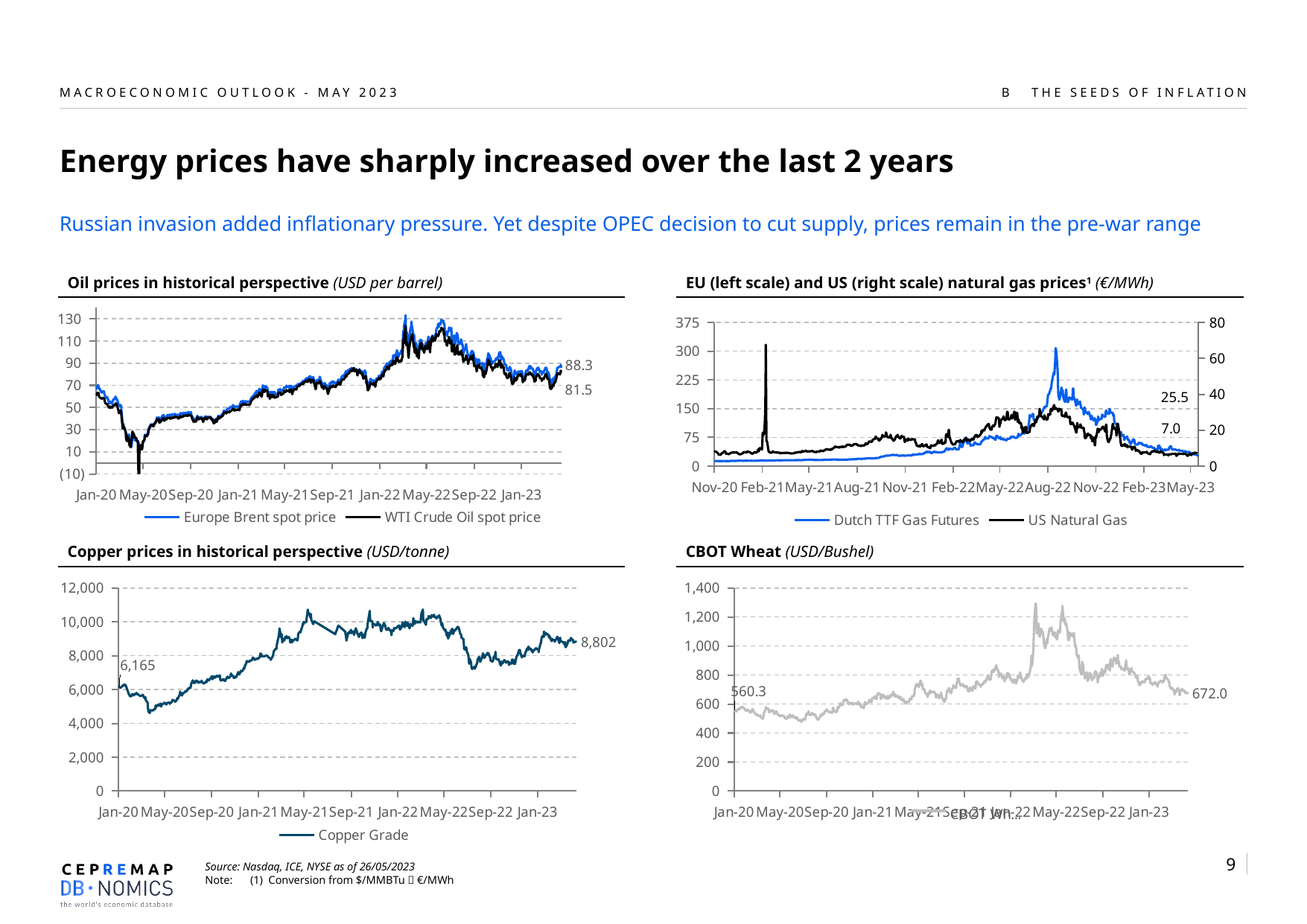
In the 'Copper prices in historical perspective' chart, is the peak value of Copper Grade greater or less than 10,000? greater In the 'Copper prices in historical perspective' chart, what is the last labelled value of Copper Grade? 8,802 In the 'Copper prices in historical perspective' chart, what is the first labelled value of Copper Grade? 6,165 In the 'Oil prices in historical perspective' chart, what is the difference between the latest labelled Brent value and the latest labelled WTI value? 6.8 In the 'Oil prices in historical perspective' chart, what is the latest labelled value for WTI Crude Oil spot price? 81.5 In the 'Oil prices in historical perspective' chart, which series has the higher latest labelled value, Europe Brent spot price or WTI Crude Oil spot price? Europe Brent spot price In the 'CBOT Wheat' chart, what is the last labelled value? 672.0 In the 'Oil prices in historical perspective' chart, what is the latest labelled value for Europe Brent spot price? 88.3 How many series does the legend of the 'Oil prices in historical perspective' chart list? 2 In the 'CBOT Wheat' chart, what is the difference between the last labelled value (672.0) and the first labelled value (560.3)? 111.7 What are the two legend entries of the 'EU (left scale) and US (right scale) natural gas prices' chart? Dutch TTF Gas Futures and US Natural Gas What kind of chart is the 'Oil prices in historical perspective' chart? line chart